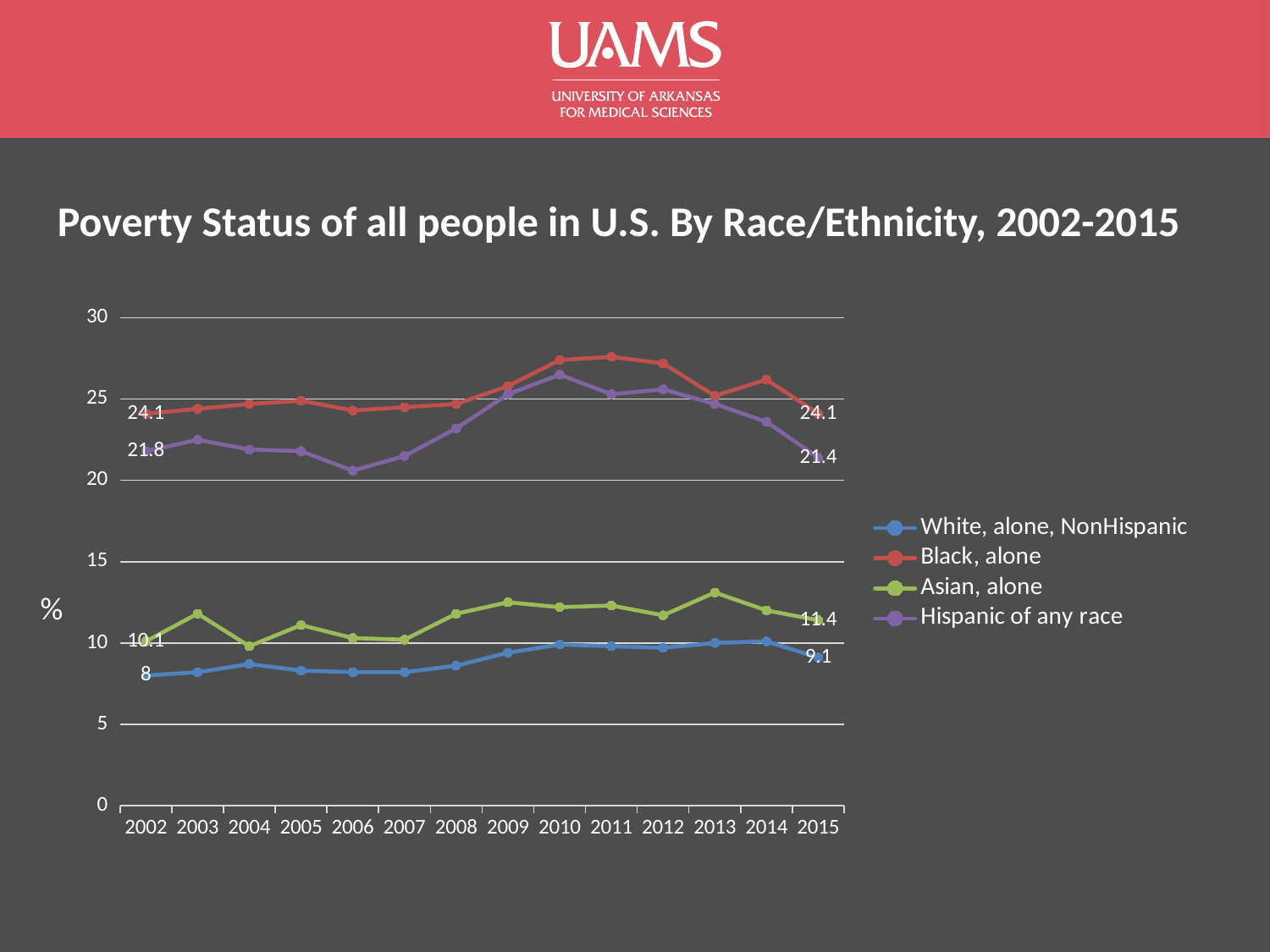
What is the poverty rate for Asian, alone in 2015? 11.4 Which is larger in 2015: the poverty rate for Asian, alone or for White, alone, NonHispanic? Asian, alone Which series has the highest poverty rate in 2015? Black, alone How many years are shown on the x axis? 14 How many series does the legend list? 4 What is the difference between the Hispanic of any race poverty rate in 2002 and in 2015? 0.4 What is the poverty rate for White, alone, NonHispanic in 2002? 8 Is the value for Black, alone in 2011 greater or less than 25? greater Which series has the lowest poverty rate in 2002? White, alone, NonHispanic What is the poverty rate for Hispanic of any race in 2015? 21.4 What type of chart is shown on the slide? line chart What is the poverty rate for Black, alone in 2002? 24.1